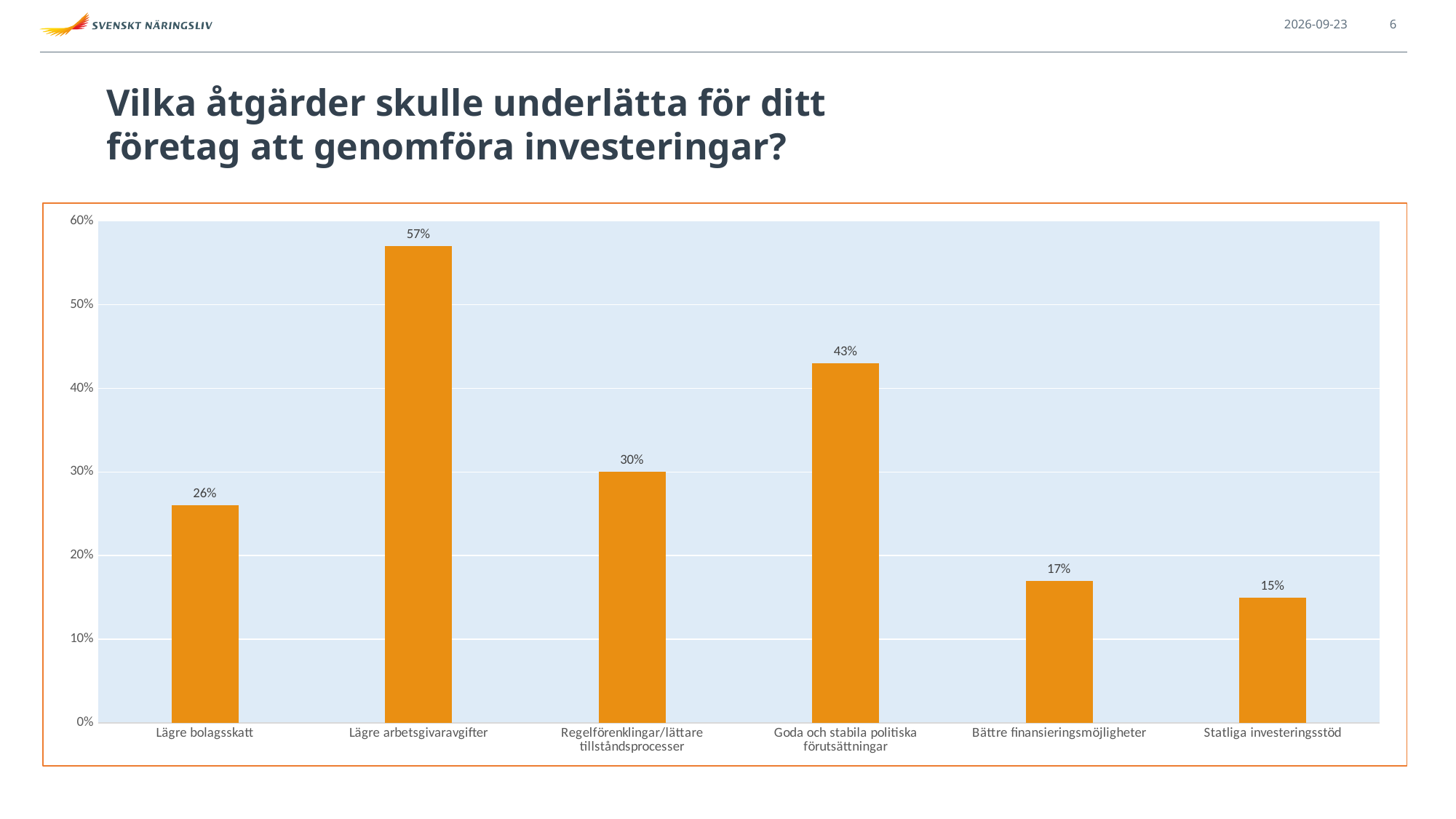
How many categories are shown in the chart? 6 What is the value for Lägre arbetsgivaravgifter? 57% What is the value for Goda och stabila politiska förutsättningar? 43% What kind of chart is shown on the slide? bar chart Which category has the lowest value? Statliga investeringsstöd What is the value for Statliga investeringsstöd? 15% Which category has the highest value? Lägre arbetsgivaravgifter What is the difference between the values for Lägre bolagsskatt and Statliga investeringsstöd? 11% Which is larger, the value for Lägre bolagsskatt or the value for Regelförenklingar/lättare tillståndsprocesser? Regelförenklingar/lättare tillståndsprocesser What is the difference between the values for Lägre arbetsgivaravgifter and Goda och stabila politiska förutsättningar? 14% What is the value for Regelförenklingar/lättare tillståndsprocesser? 30% Is the value for Bättre finansieringsmöjligheter greater or less than 20%? less